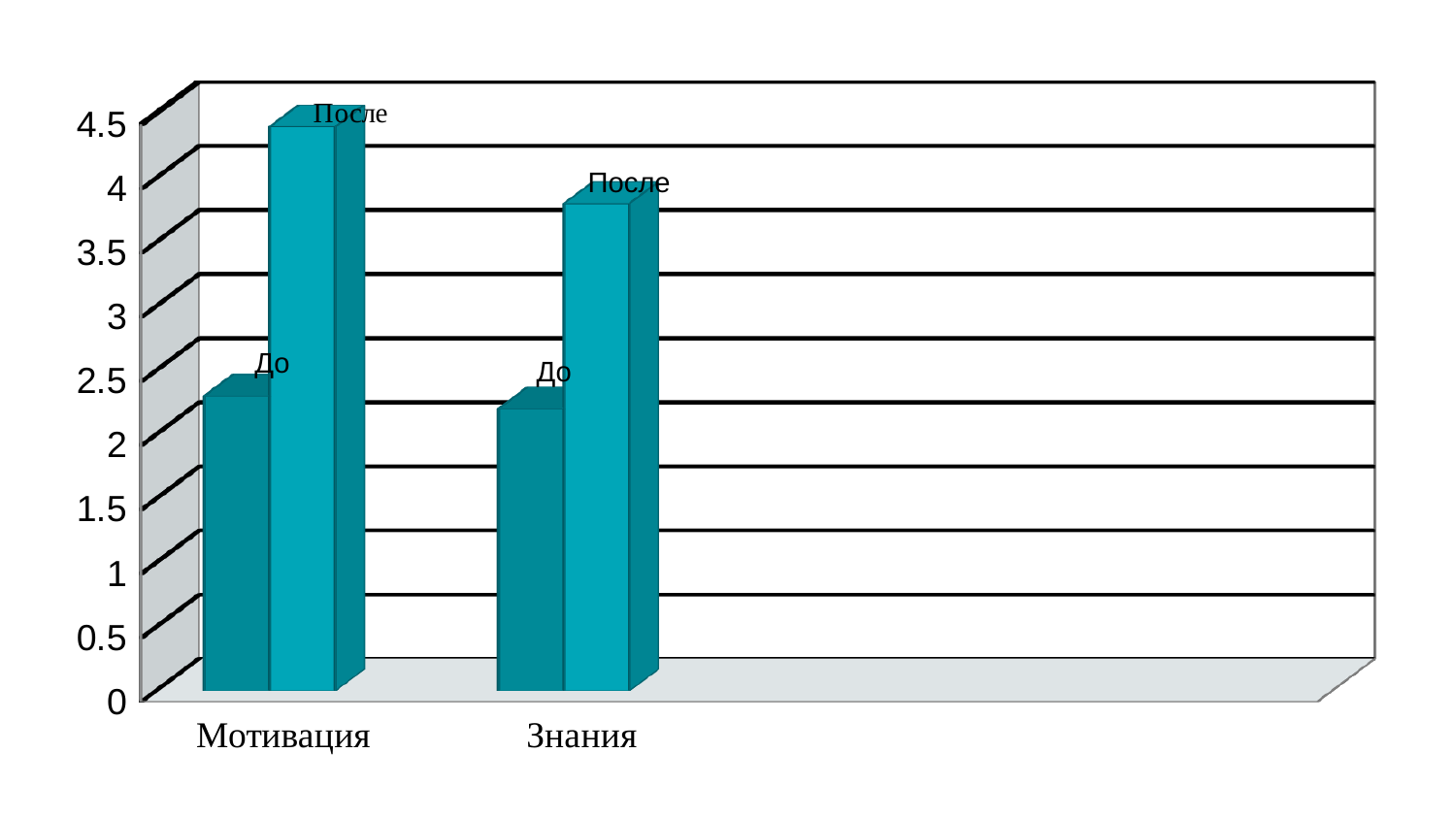
Which is larger: the 'После' value for Мотивация or the 'После' value for Знания? Мотивация Is the 'До' value for Знания greater or less than 3? less What kind of chart is shown on the slide? bar chart Is the 'После' value for Мотивация greater or less than 4? greater Is the 'До' value for Мотивация greater or less than 2? greater Which category has the tallest bar on the chart? Мотивация For the category Знания, which bar is taller, 'До' or 'После'? После How many categories are shown on the x axis? 2 What are the two labels written above the bars in each category? До and После